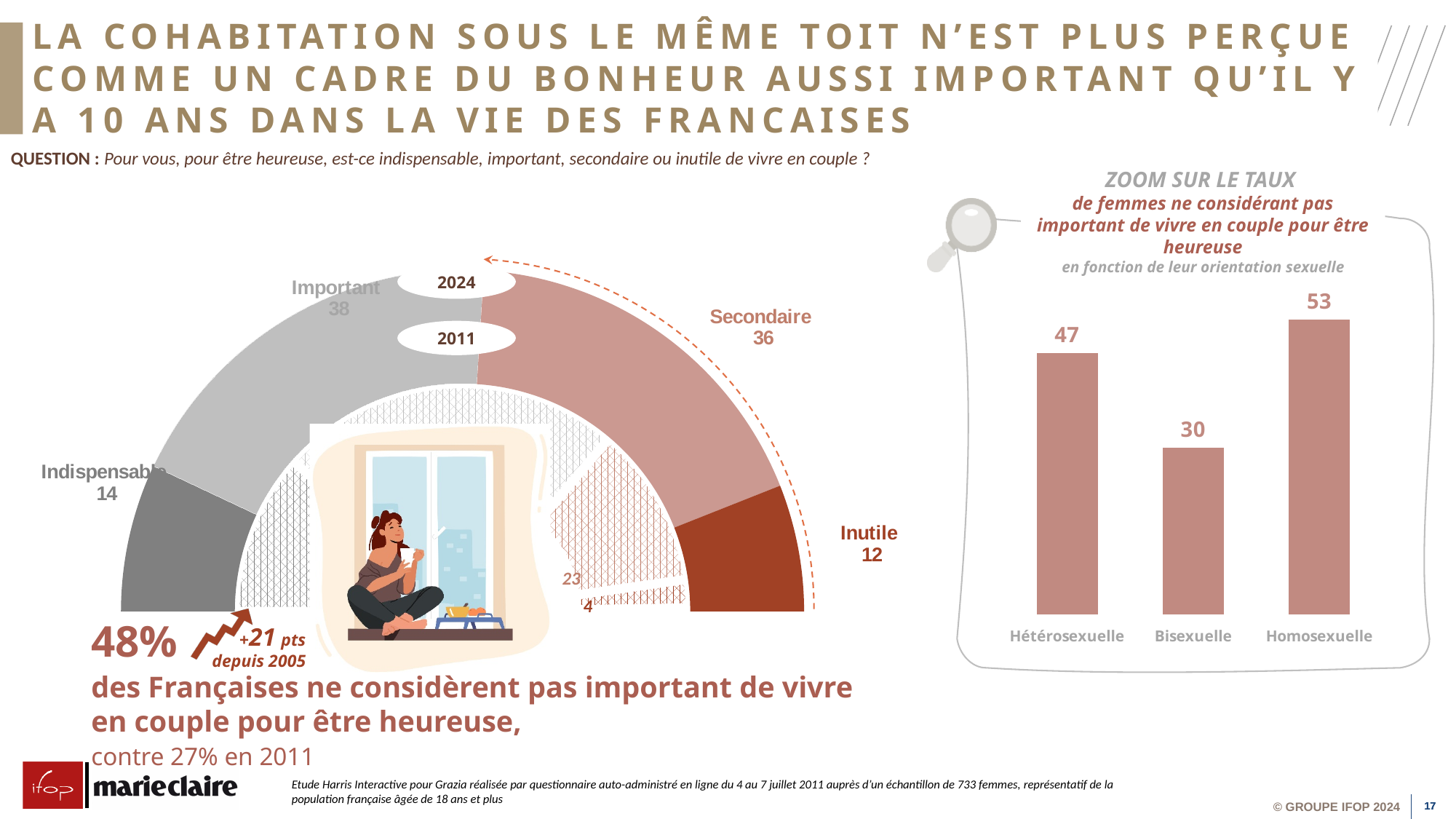
In the bar chart on the right, what is the difference between the values for Homosexuelle and Bisexuelle? 23 In the semicircular chart on the left, what is the 2024 value for Inutile? 12 In the semicircular chart on the left, what is the difference between the 2024 values for Important and Indispensable? 24 In the bar chart on the right, what is the value for Homosexuelle? 53 In the bar chart on the right, what is the value for Bisexuelle? 30 In the bar chart on the right, what is the value for Hétérosexuelle? 47 In the semicircular chart on the left, which 2024 category has the highest value? Important In the bar chart on the right, which category has the lowest value? Bisexuelle In the bar chart on the right, how many categories are shown? 3 What kind of chart is shown on the right of the slide? Bar chart In the semicircular chart on the left, what is the 2024 value for Secondaire? 36 In the bar chart on the right, which category has the highest value? Homosexuelle